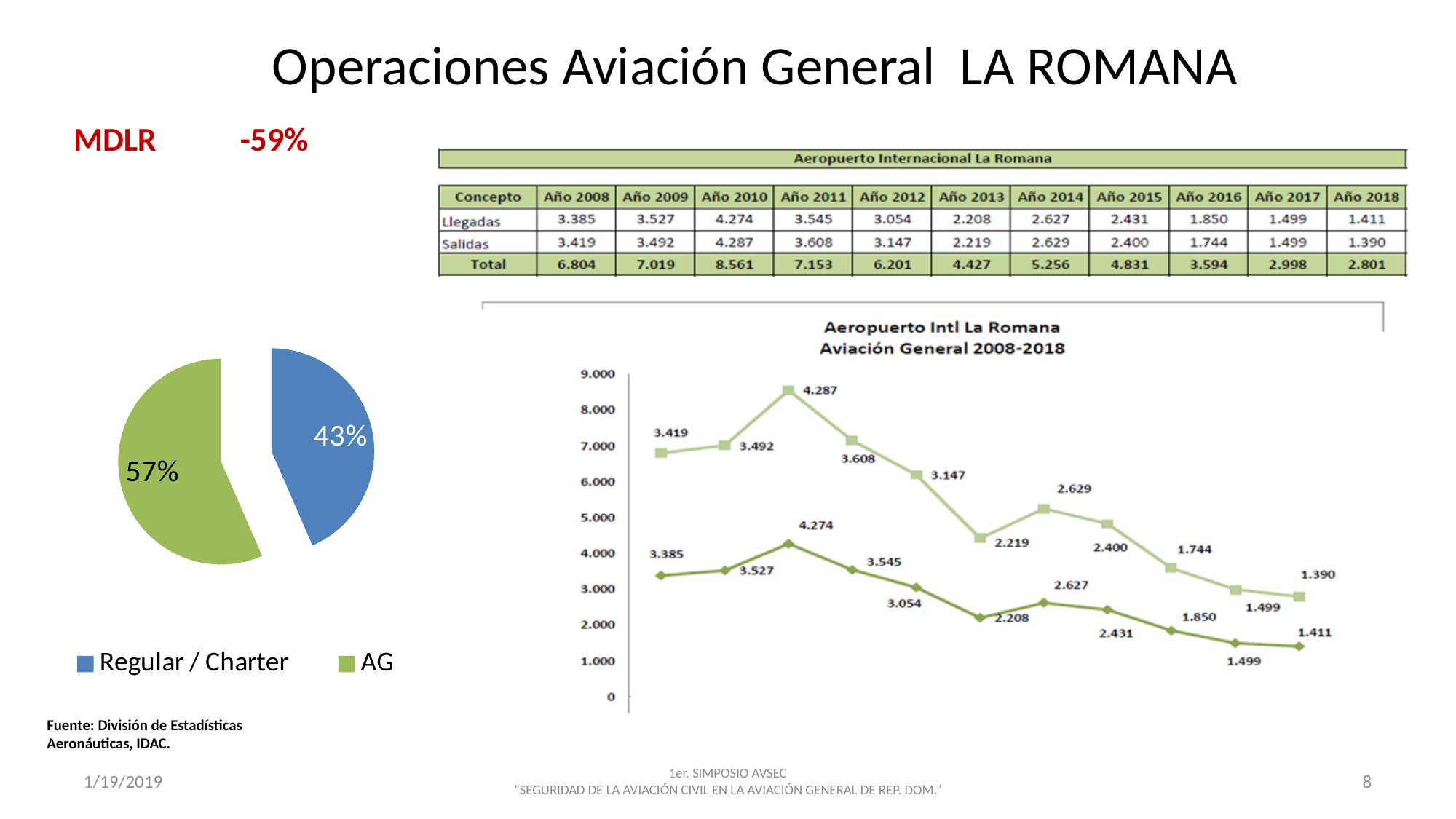
In the 'Aeropuerto Intl La Romana Aviación General 2008-2018' chart, how many data points does each line have? 11 In the pie chart, what share does Regular / Charter have? 43% How many entries does the legend of the pie chart list? 2 In the 'Aeropuerto Intl La Romana Aviación General 2008-2018' chart, what is the highest labeled value on the lower line? 4.274 In the 'Aeropuerto Intl La Romana Aviación General 2008-2018' chart, is the highest point of the upper line plotted greater or less than 8.000 on the axis? greater In the pie chart, which slice is larger, Regular / Charter or AG? AG In the 'Aeropuerto Intl La Romana Aviación General 2008-2018' chart, what is the lowest labeled value on the lower line? 1.411 What kind of chart is the chart on the left of the slide? pie chart What kind of chart is the 'Aeropuerto Intl La Romana Aviación General 2008-2018' chart? line chart In the pie chart, what share does AG have? 57% In the 'Aeropuerto Intl La Romana Aviación General 2008-2018' chart, do the values generally rise or fall from left to right after the peak? fall In the 'Aeropuerto Intl La Romana Aviación General 2008-2018' chart, what is the labeled value of the last point on the upper line? 1.390